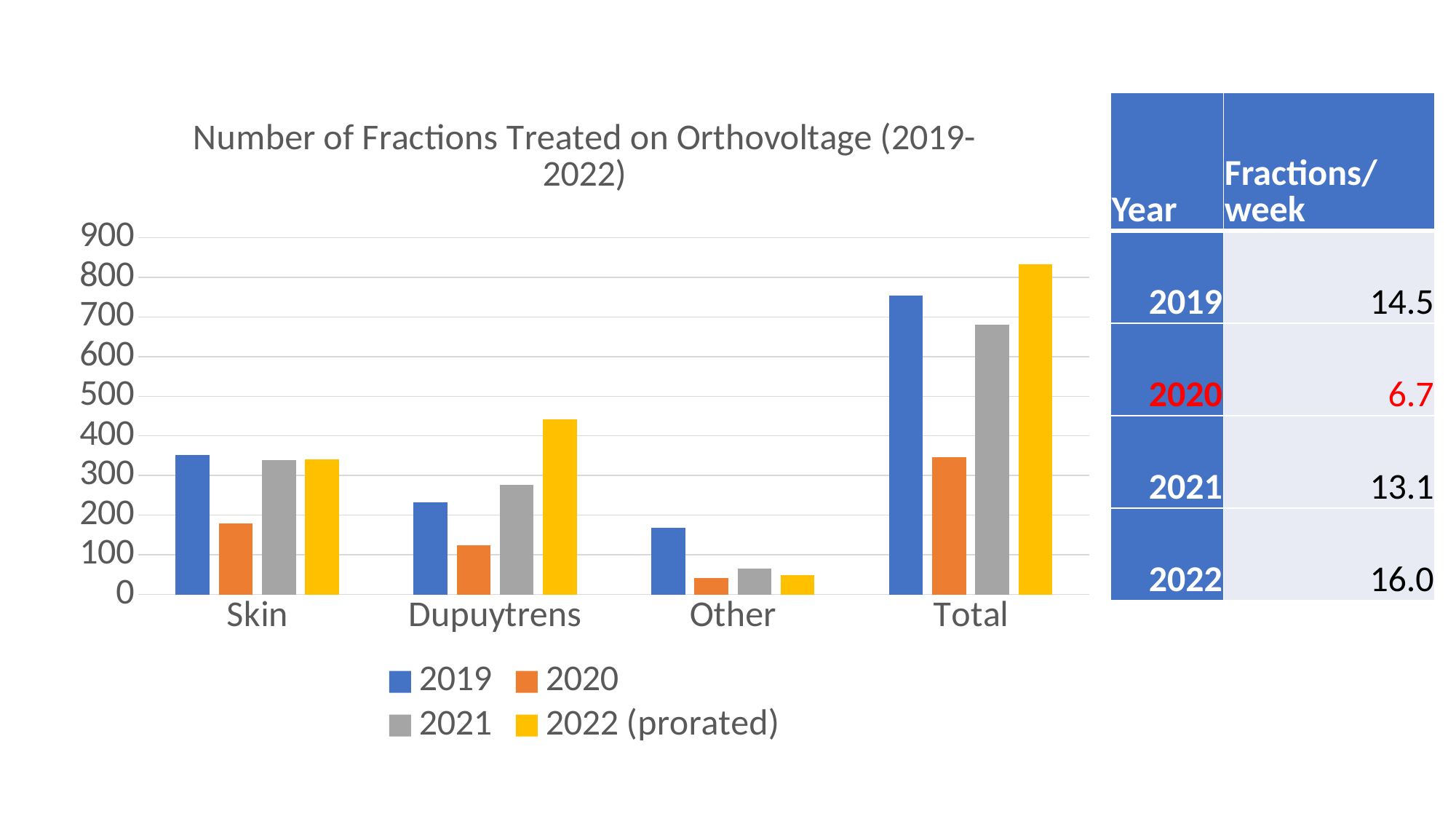
Is the value for Dupuytrens in 2022 (prorated) greater or less than 400? greater Which year has the highest bar in the Total category? 2022 (prorated) Is the value for Total in 2020 greater or less than 400? less How many series does the chart legend list? 4 Which year has the lowest bar in the Total category? 2020 Which year has the lowest bar in the Skin category? 2020 What kind of chart is shown on the slide? bar chart Is the value for Total in 2022 (prorated) greater or less than 800? greater In the Dupuytrens category, which is larger: the 2019 bar or the 2022 (prorated) bar? 2022 (prorated) How many categories are shown on the x axis of the chart? 4 What is the title of the chart? Number of Fractions Treated on Orthovoltage (2019-2022)